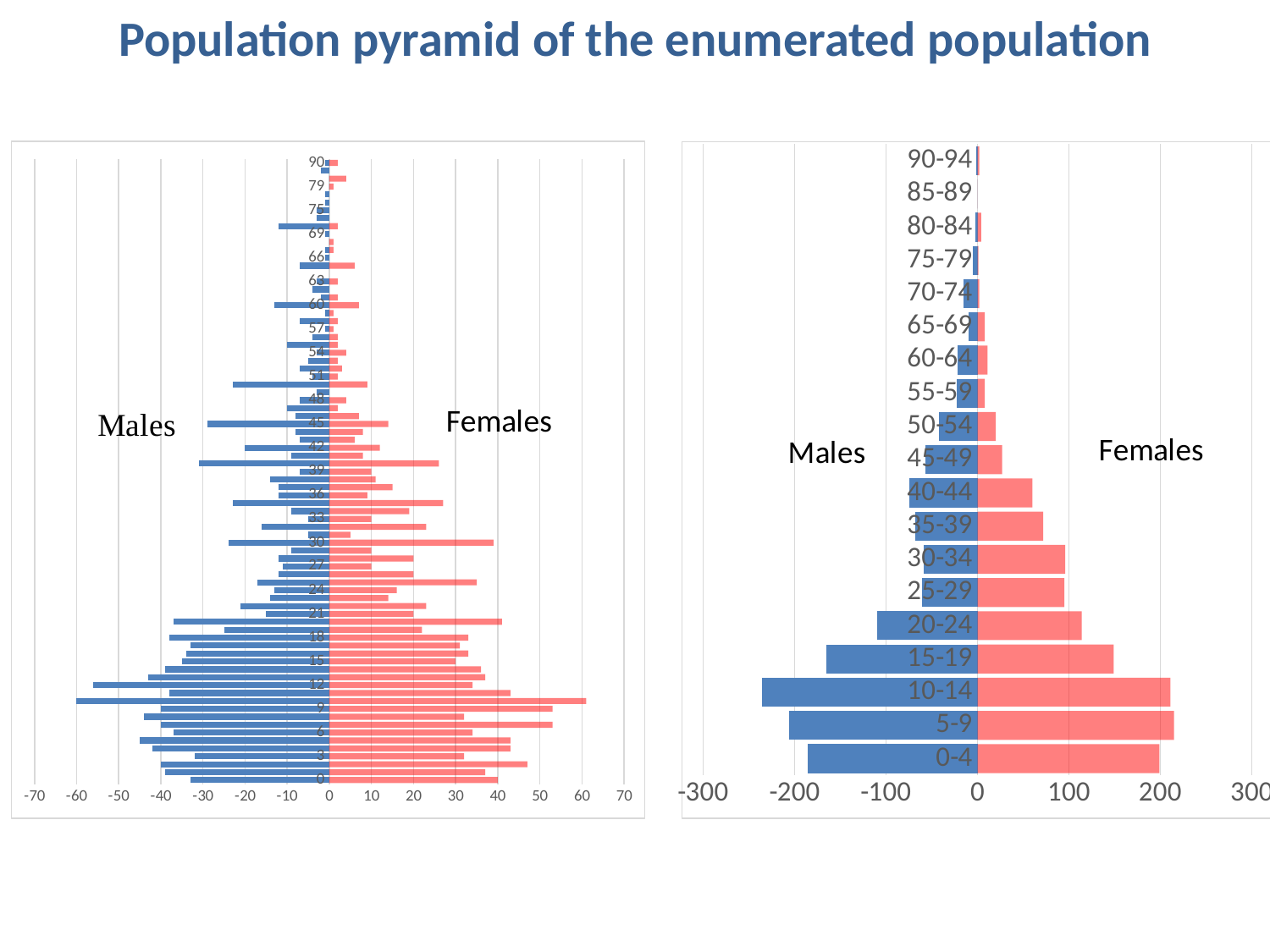
In the right-hand chart, is the Females value for the 15-19 age group greater or less than 100? greater In the right-hand chart, how many age groups are shown? 19 In the right-hand chart, which age group has the longest Males bar? 10-14 In the right-hand chart, do the Females bars generally get longer or shorter as the age group increases from 0-4 to 90-94? shorter What is the title of the slide? Population pyramid of the enumerated population In the right-hand chart, is the Females value for the 10-14 age group greater or less than 200? greater In the right-hand chart, what colour are the bars for Males? blue In the left-hand chart, is the Females value at age 9 greater or less than 50? greater What kind of chart is the right-hand chart? bar chart In the right-hand chart, is the Females bar for 15-19 longer or shorter than the Females bar for 20-24? longer